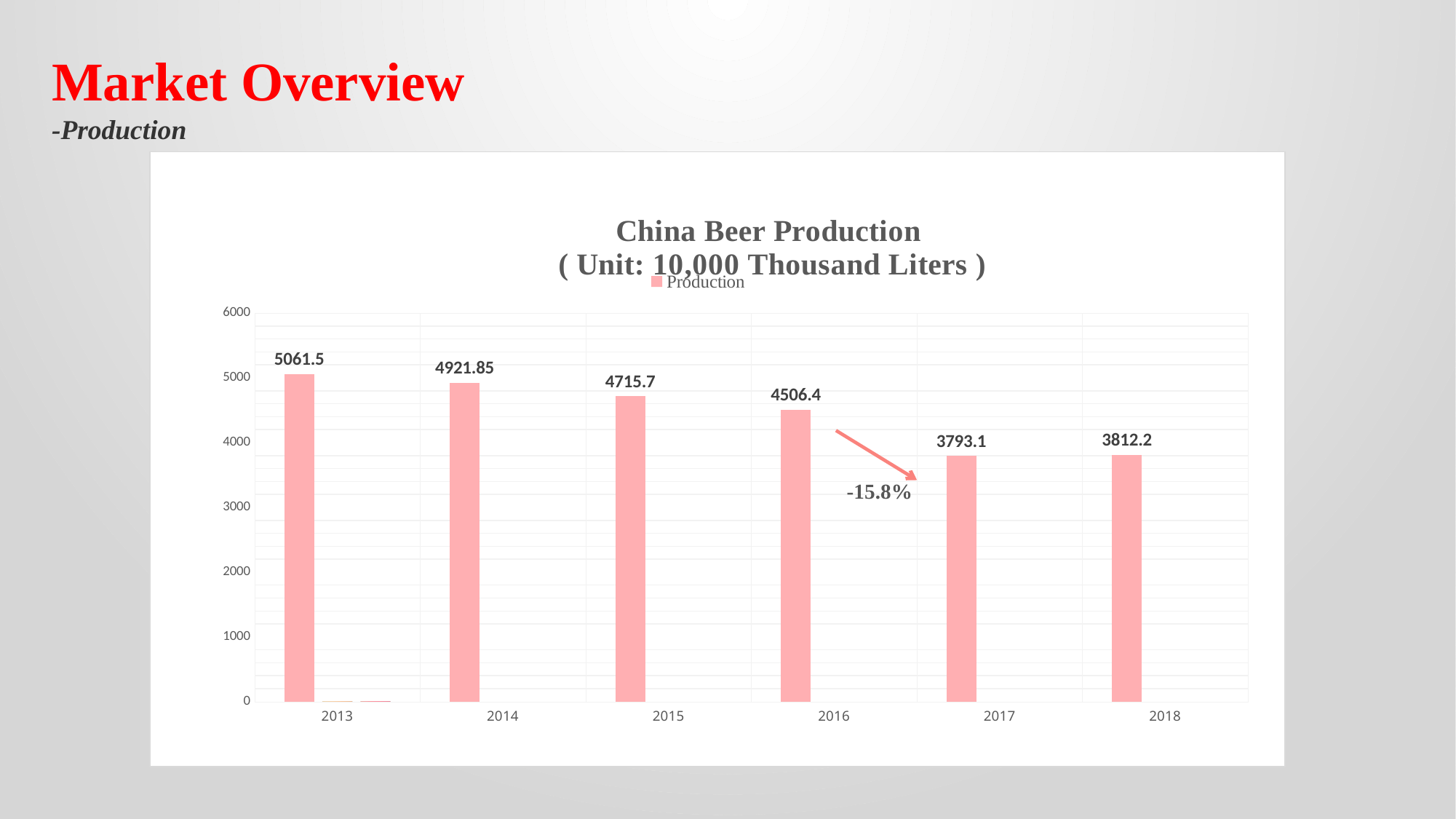
What is the difference in production between 2016 and 2017? 713.3 Which year has the lowest production? 2017 What is the production value for 2018? 3812.2 Does production generally rise or fall from 2013 to 2017? Fall Which year has the highest production? 2013 What percentage change is annotated between 2016 and 2017? -15.8% How many years are shown on the x axis? 6 What is the production value for 2013? 5061.5 What is the production value for 2016? 4506.4 What kind of chart is shown on the slide? Bar chart What is the difference in production between 2013 and 2014? 139.65 Which year has higher production, 2015 or 2016? 2015